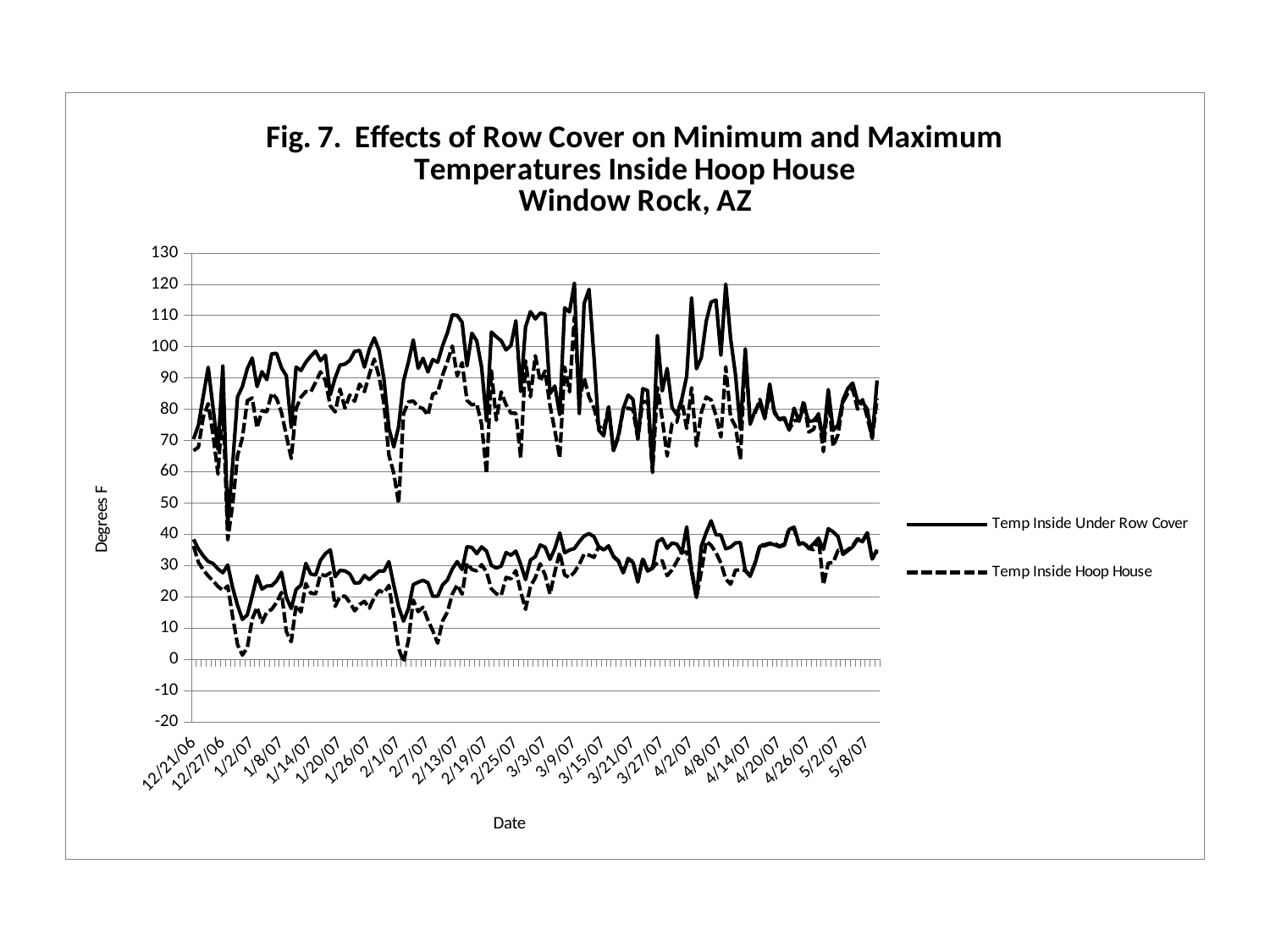
How many series does the legend list? 2 What is the first date label shown on the x axis? 12/21/06 How many date labels are shown along the x axis? 24 What is the label on the horizontal axis? Date What is the title of the chart? Fig. 7. Effects of Row Cover on Minimum and Maximum Temperatures Inside Hoop House Window Rock, AZ What kind of chart is shown on the slide? line chart Which series is drawn with a dashed line? Temp Inside Hoop House Is the highest maximum temperature reached by the Temp Inside Under Row Cover series greater or less than 110? greater What is the last date label shown on the x axis? 5/8/07 Is the lowest minimum temperature reached by the Temp Inside Hoop House series greater or less than 10? less Which series reaches the higher peak maximum temperature, Temp Inside Under Row Cover or Temp Inside Hoop House? Temp Inside Under Row Cover What is the label on the vertical axis? Degrees F